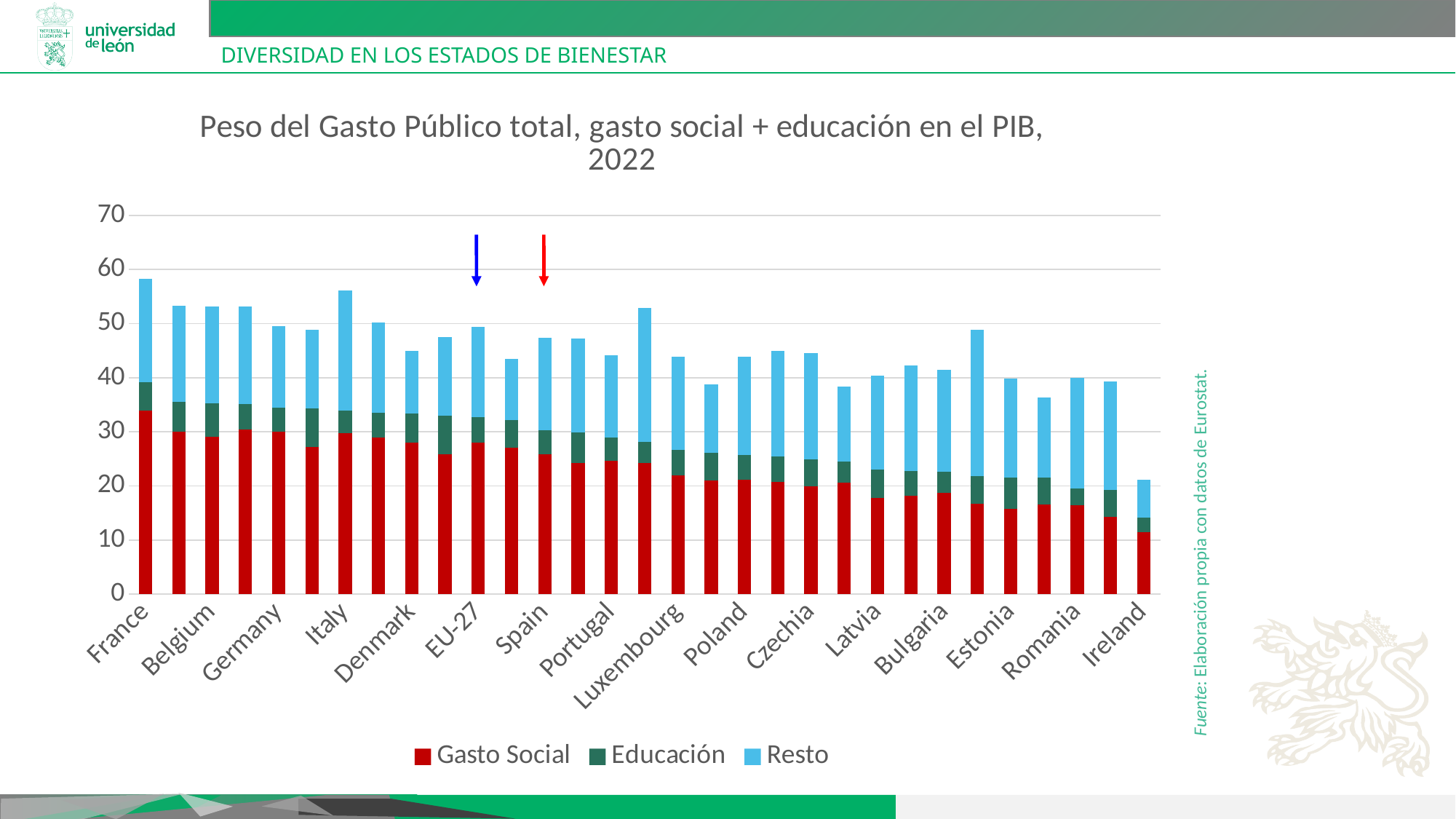
Do the total bar heights generally rise or fall from left to right along the x axis? fall Is the total value for Spain greater or less than 50? less Which labelled country has the lowest total bar? Ireland How many series does the legend list? 3 Is the total value for Ireland greater or less than 30? less Is the total value for France greater or less than 50? greater What kind of chart is shown on the slide? Stacked bar chart Which series are listed in the legend? Gasto Social, Educación, Resto Which has the larger total bar, Belgium or Poland? Belgium Which labelled country has the highest total bar? France